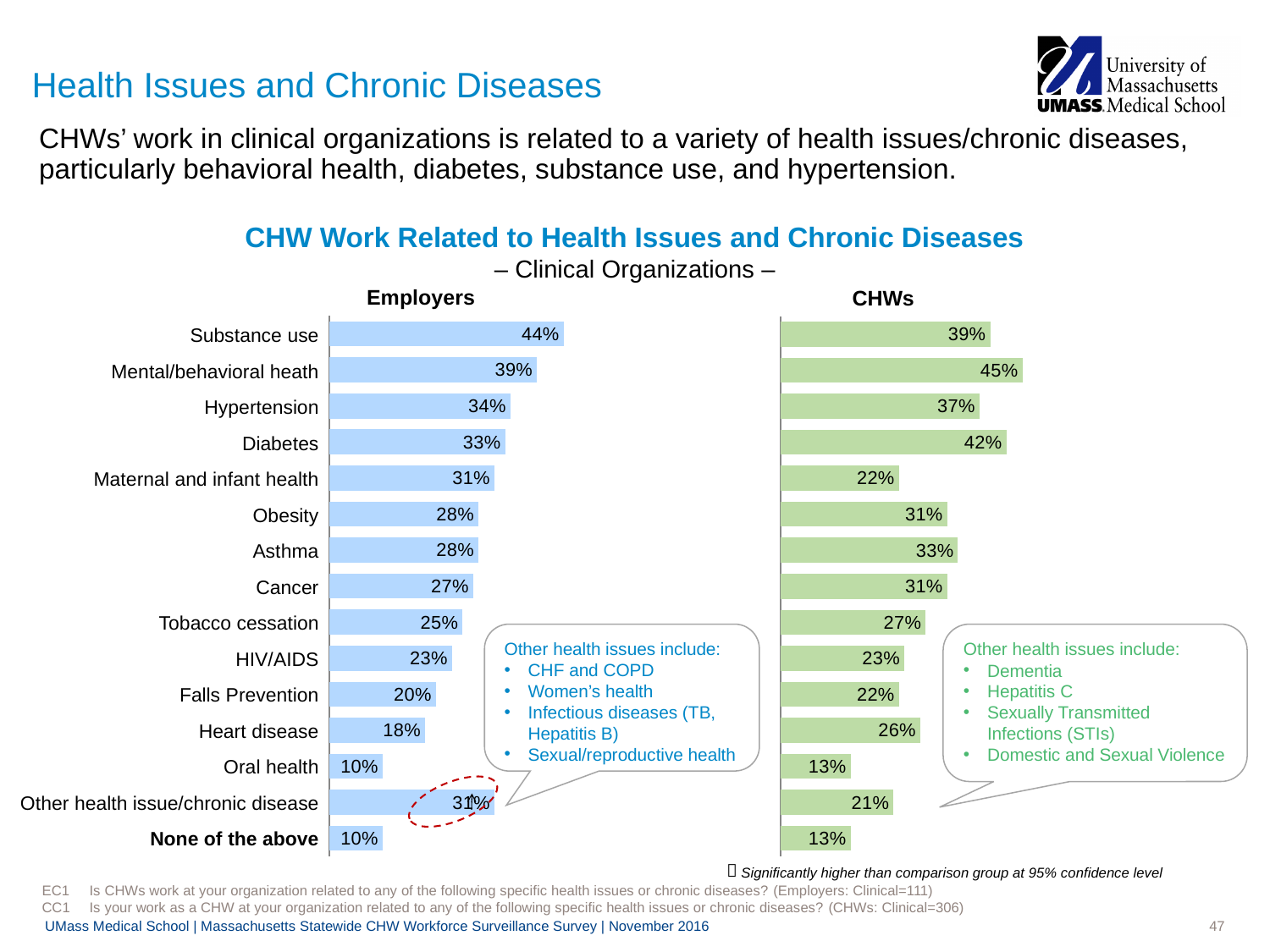
In the Employers chart, what percentage is shown for Substance use? 44% In the CHWs chart, which health issue has the highest percentage? Mental/behavioral heath In the CHWs chart, what percentage is shown for Diabetes? 42% In the Employers chart, which health issue has the highest percentage? Substance use In the CHWs chart, what percentage is shown for None of the above? 13% What is the title of the chart on the slide? CHW Work Related to Health Issues and Chronic Diseases Which is larger: the Employers value for Heart disease or the CHWs value for Heart disease? CHWs In the Employers chart, what is the difference between the percentages for Substance use and Hypertension? 10% In the CHWs chart, what is the difference between the percentages for Mental/behavioral heath and Maternal and infant health? 23% In the Employers chart, what percentage is shown for Oral health? 10% What type of chart is used to show the Employers and CHWs data? Bar chart Which is larger: the Employers value for Maternal and infant health or the CHWs value for Maternal and infant health? Employers